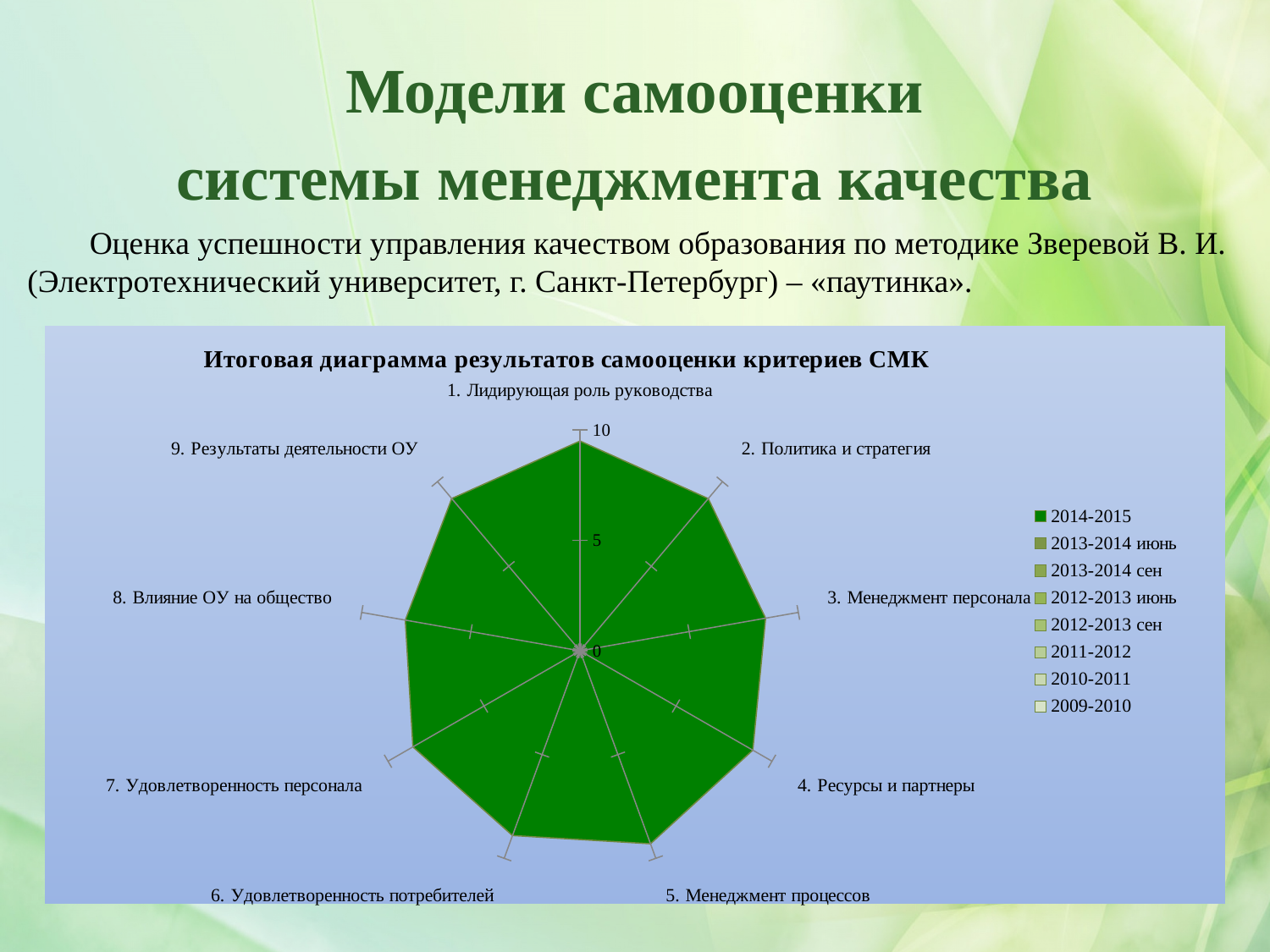
Is the value for '6. Удовлетворенность потребителей' in the 2014-2015 series greater or less than 5? greater What kind of chart is shown on the slide? radar chart How many criteria (categories) are plotted around the radar chart? 9 Is the value for '3. Менеджмент персонала' in the 2014-2015 series greater or less than 5? greater Is the value for '4. Ресурсы и партнеры' in the 2014-2015 series greater or less than 5? greater Which series is listed first in the chart legend? 2014-2015 What is the maximum value shown on the radar chart's axis? 10 What is the title of the chart? Итоговая диаграмма результатов самооценки критериев СМК How many series does the chart legend list? 8 Which category label appears at the top of the radar chart? 1. Лидирующая роль руководства